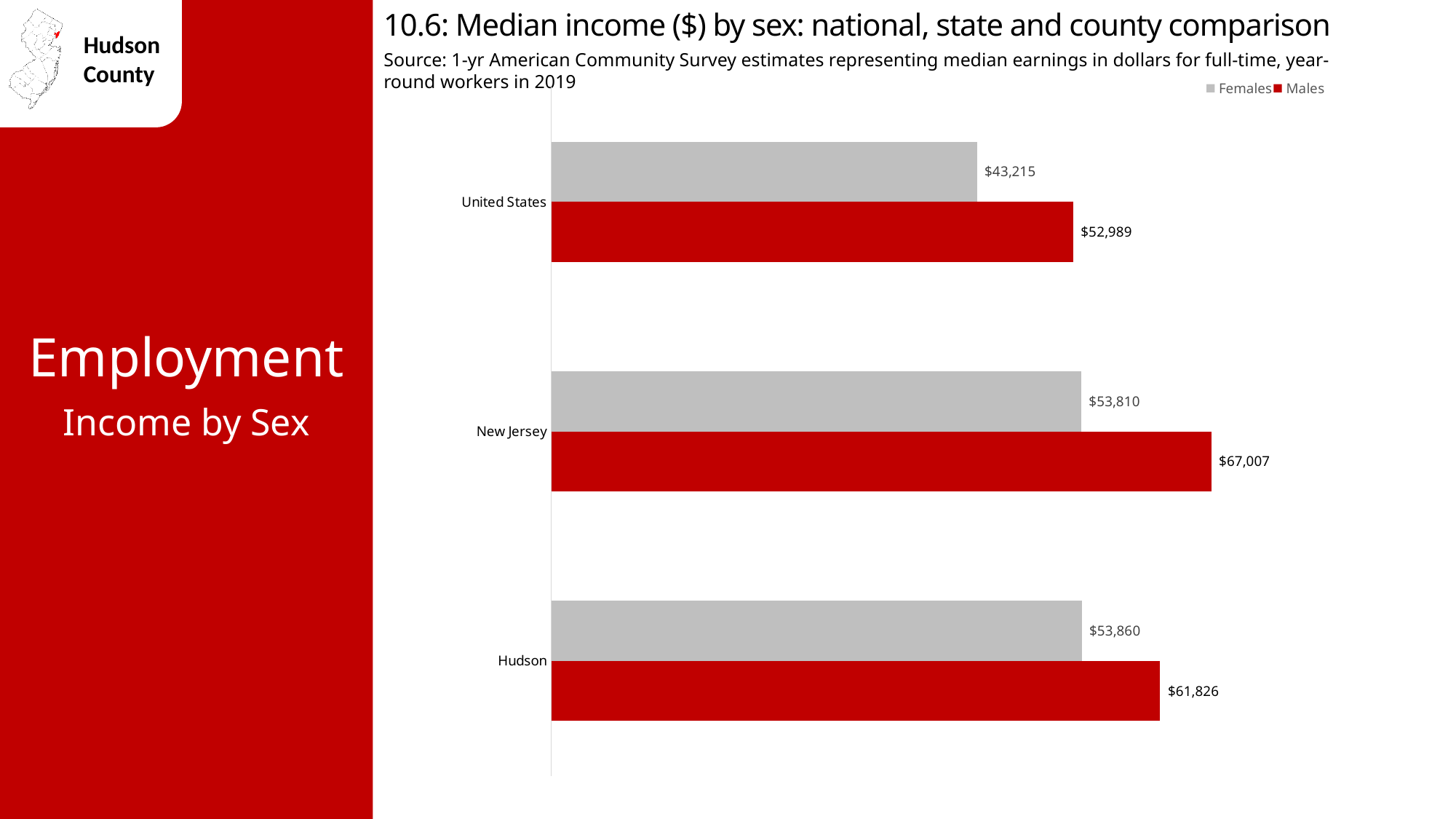
What is the median income for females in the United States? $43,215 What is the median income for males in New Jersey? $67,007 How many categories are shown on the chart? 3 Which category has the highest median income for males? New Jersey What is the median income for females in Hudson? $53,860 Which category has the lowest median income for females? United States What is the difference between male and female median income in New Jersey? $13,197 Which is larger: the male median income in Hudson or the male median income in the United States? Hudson How many series does the legend list? 2 What is the median income for males in Hudson? $61,826 What is the difference between male and female median income in the United States? $9,774 What kind of chart is shown on the slide? Bar chart